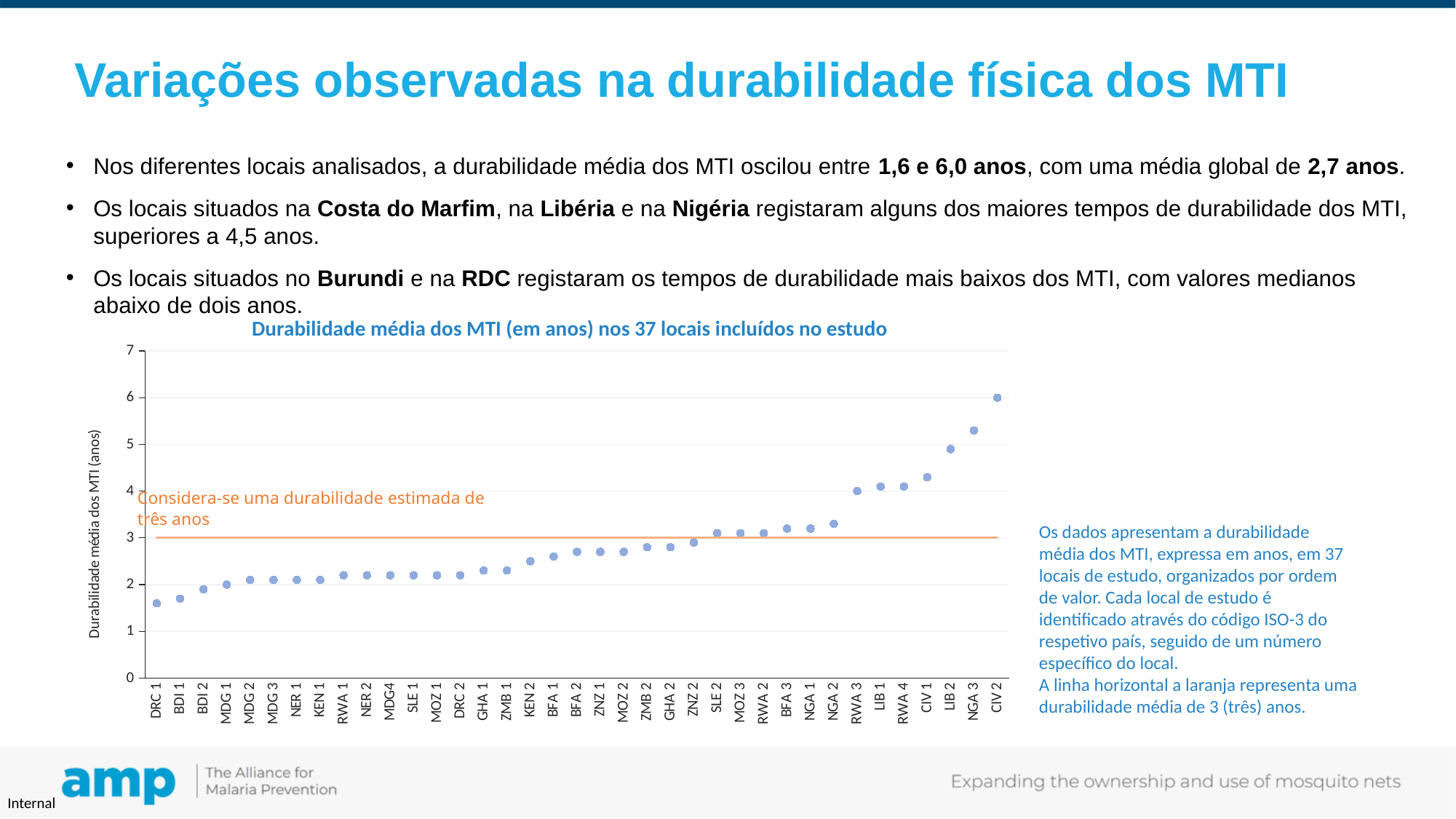
Which has a higher average durability, NGA 3 or BDI 1? NGA 3 Which location has the highest average durability in the chart? CIV 2 What kind of chart is shown on the slide? scatter chart Do the plotted values rise or fall from left to right along the x axis? rise How many study locations are plotted in the chart? 37 Which location has the lowest average durability in the chart? DRC 1 Is the value for KEN 2 greater or less than 3? less What is the average durability value for CIV 2? 6 Is the value for CIV 1 greater or less than 4? greater Is the value for RWA 3 greater or less than 3? greater What is the title of the chart? Durabilidade média dos MTI (em anos) nos 37 locais incluídos no estudo